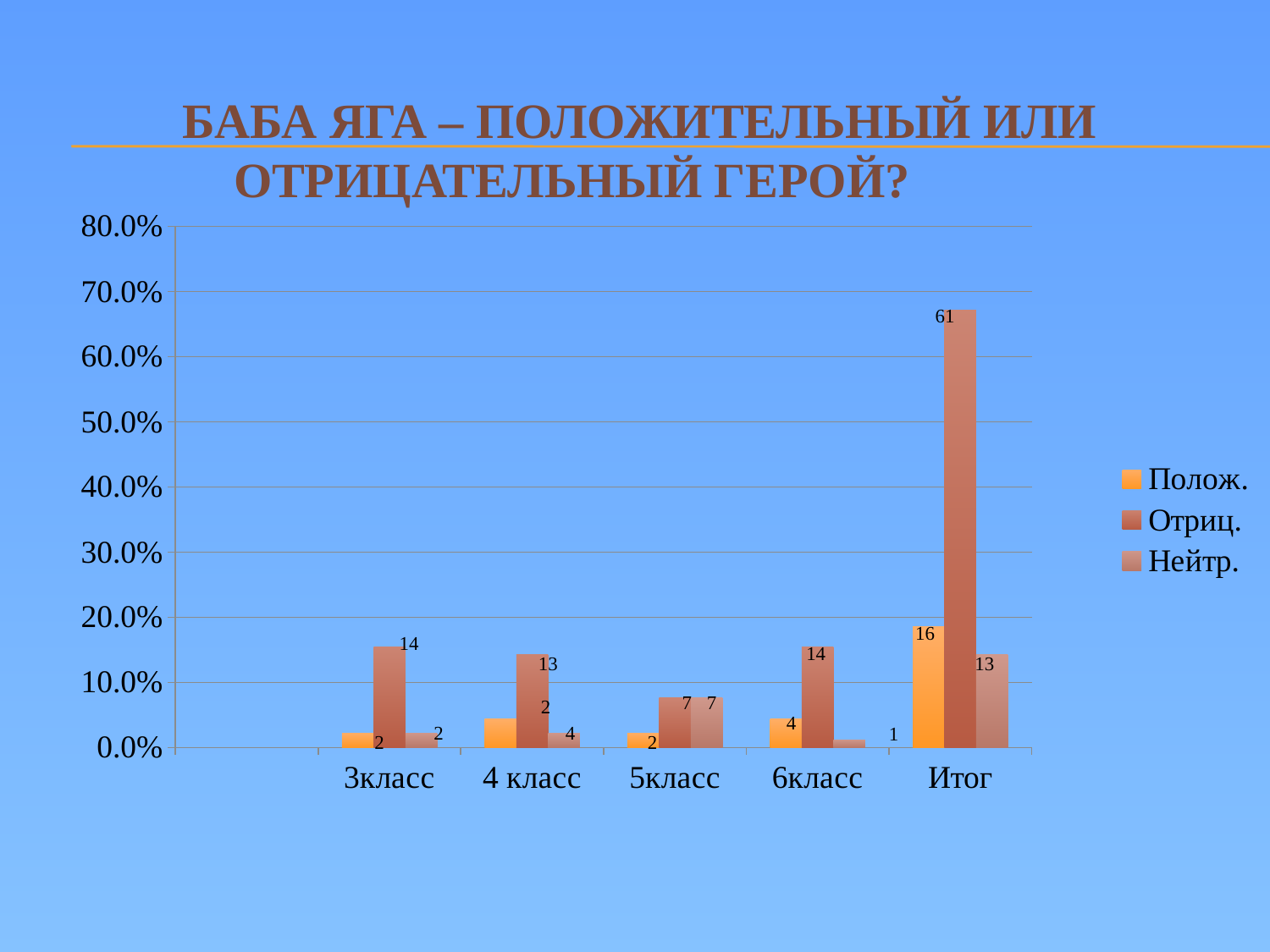
What is the data label for Полож. in the Итог category? 16 Which category has the highest Отриц. bar? Итог Which category has the lowest Нейтр. bar? 6класс How many categories are shown on the x axis? 5 Is the Отриц. bar for Итог greater or less than 60.0%? greater What is the data label for Отриц. in the Итог category? 61 Which series is shown in orange in the legend? Полож. What is the data label for Отриц. in the 6класс category? 14 What is the difference between the Отриц. and Полож. data labels in the Итог category? 45 What kind of chart is shown on the slide? bar chart How many series does the legend list? 3